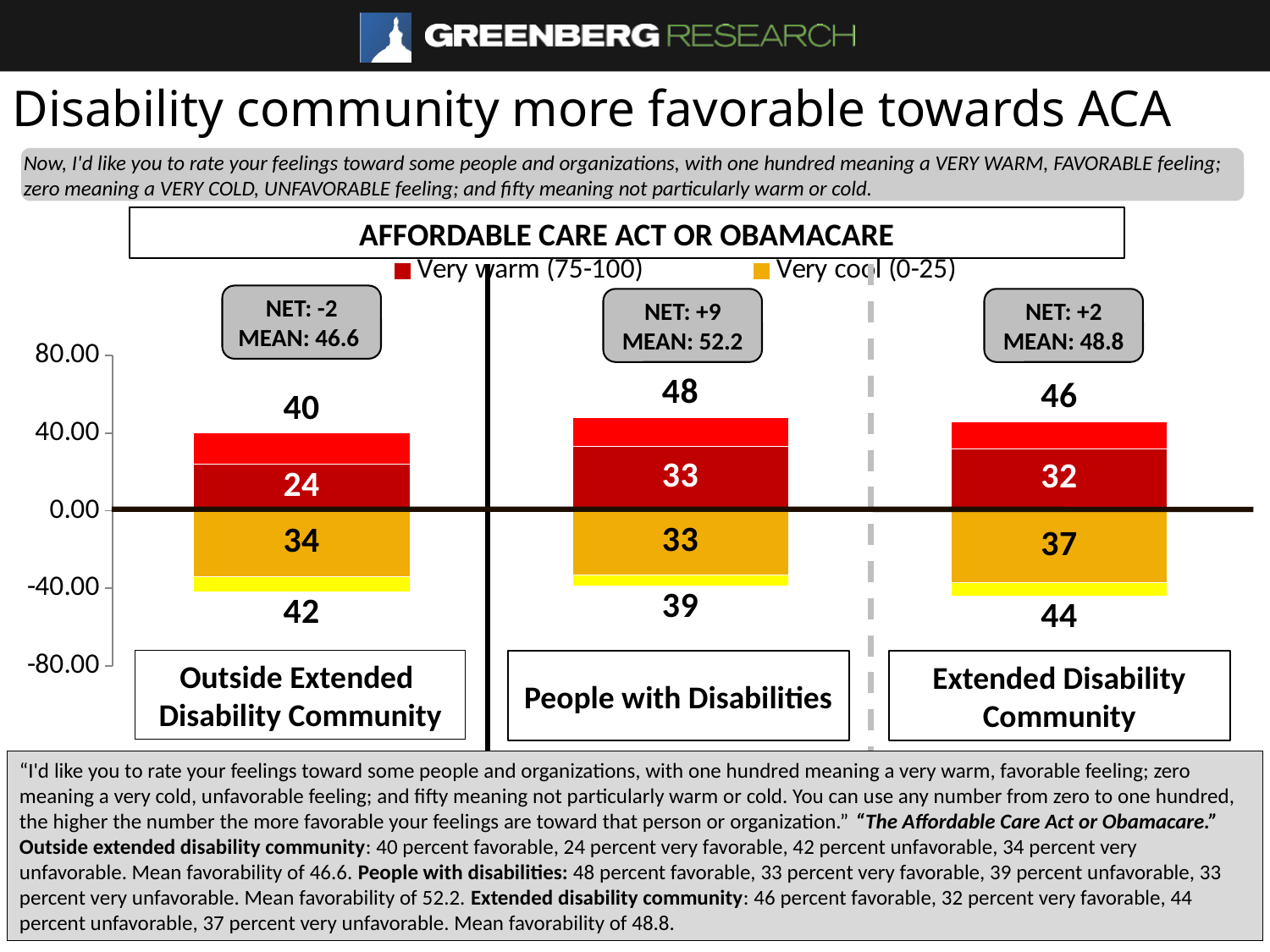
What mean favorability is shown for People with Disabilities? 52.2 How many series does the chart legend list? 2 What is the 'Very warm (75-100)' value for the Extended Disability Community? 32 Which is larger: the 'Very cool (0-25)' value for the Extended Disability Community or for People with Disabilities? Extended Disability Community How many groups are shown on the x axis of the chart? 3 What is the difference between the total favorable values for People with Disabilities and the Outside Extended Disability Community? 8 What is the total unfavorable (cool) value shown below the bar for the Extended Disability Community? 44 Which group has the highest 'Very warm (75-100)' value? People with Disabilities Which group has the lowest total favorable value? Outside Extended Disability Community What kind of chart is shown on the slide? Bar chart What is the 'Very cool (0-25)' value for the Outside Extended Disability Community? 34 What is the total favorable (warm) value shown above the bar for People with Disabilities? 48